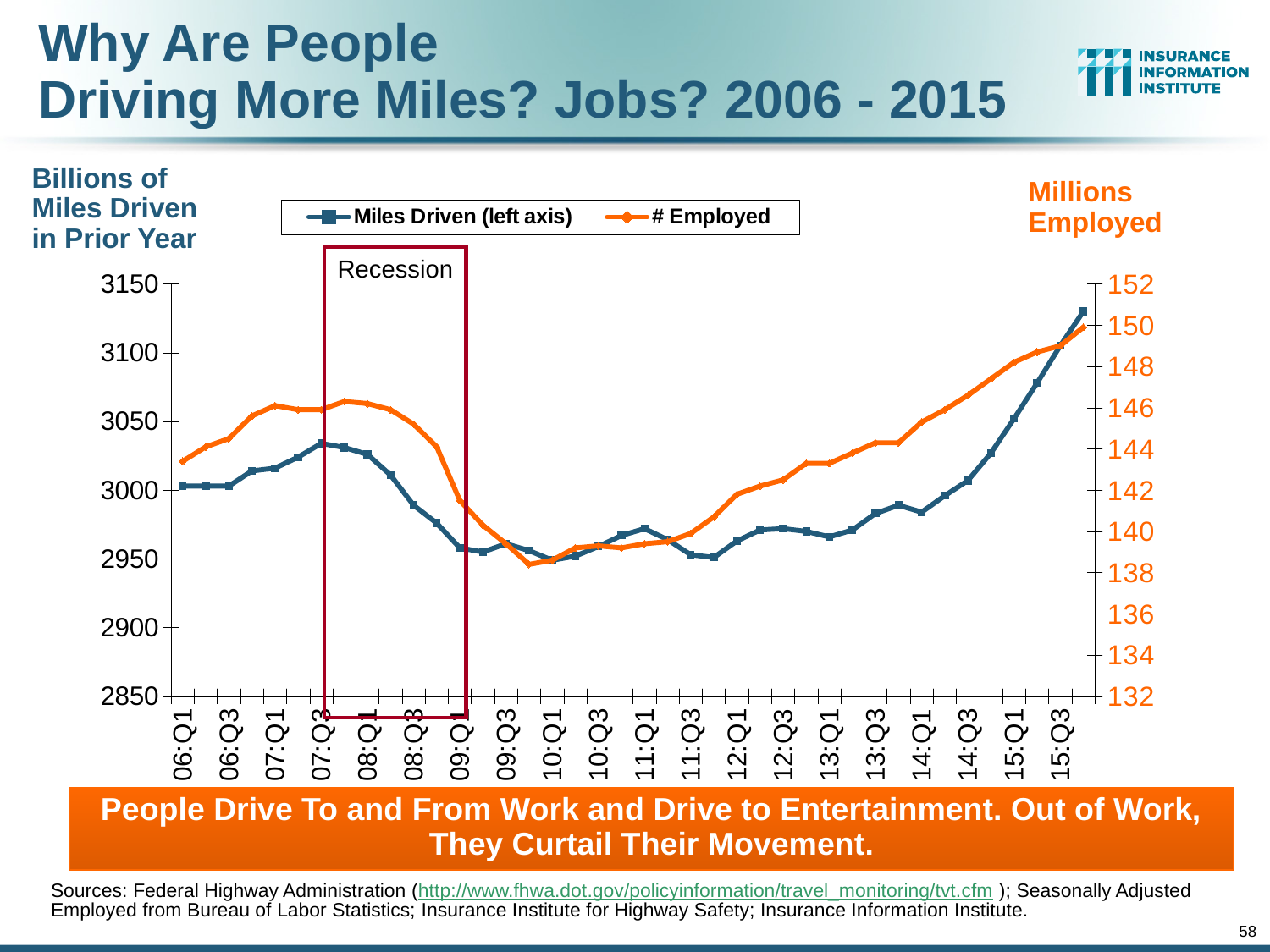
What kind of chart is shown on the slide? Line chart Which is larger for Miles Driven: the value at 07:Q3 or the value at 09:Q1? 07:Q3 Does the Miles Driven series rise or fall between 07:Q3 and 09:Q1? Fall Is the Miles Driven value at 09:Q1 greater or less than 3000? less What label is written inside the red box drawn over the chart? Recession Is the Miles Driven value at 07:Q3 greater or less than 3000? greater Does the # Employed series rise or fall between 12:Q1 and 15:Q3? Rise How many quarter labels are printed along the x axis? 20 How many series does the legend list? 2 Is the # Employed value at 15:Q3 greater or less than 146? greater What are the two series named in the legend? Miles Driven (left axis) and # Employed